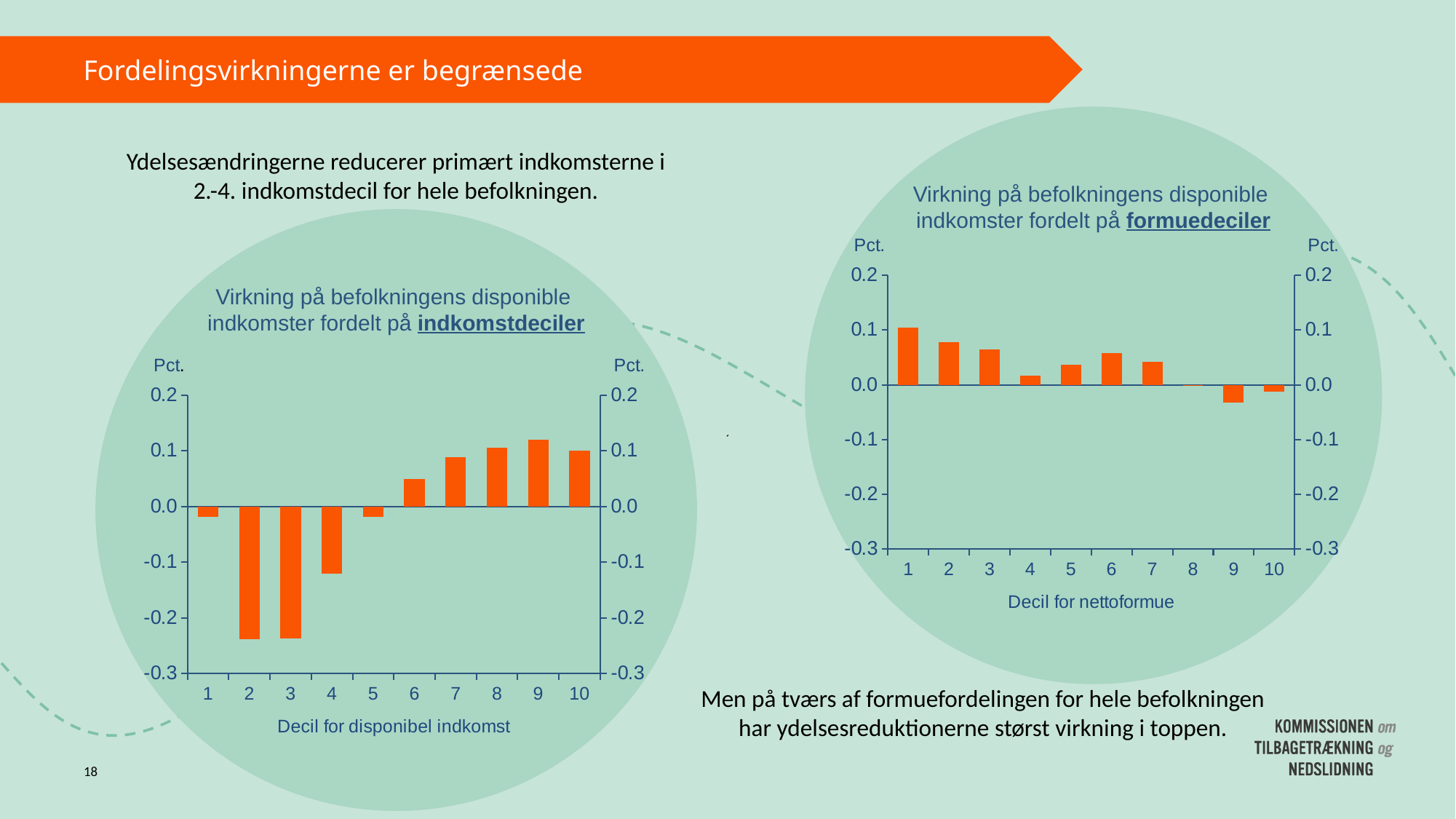
What kind of chart is the chart titled 'Virkning på befolkningens disponible indkomster fordelt på indkomstdeciler'? Bar chart In the chart on the right (formuedeciler), is the value for decile 2 greater or less than 0.1? less In the chart on the left (indkomstdeciler), which decile has the highest value? 9 In the chart on the left (indkomstdeciler), is the value for decile 4 greater or less than -0.1? less How many deciles are shown on the x axis of the chart on the left (indkomstdeciler)? 10 What is the x-axis label of the chart on the left (indkomstdeciler)? Decil for disponibel indkomst In the chart on the left (indkomstdeciler), is the value for decile 9 greater or less than 0.1? greater In the chart on the right (formuedeciler), which decile has the lowest value? 9 In the chart on the right (formuedeciler), which decile has the highest value? 1 In the chart on the right (formuedeciler), which has the larger value, decile 1 or decile 6? Decile 1 In the chart on the left (indkomstdeciler), which has the larger value, decile 4 or decile 2? Decile 4